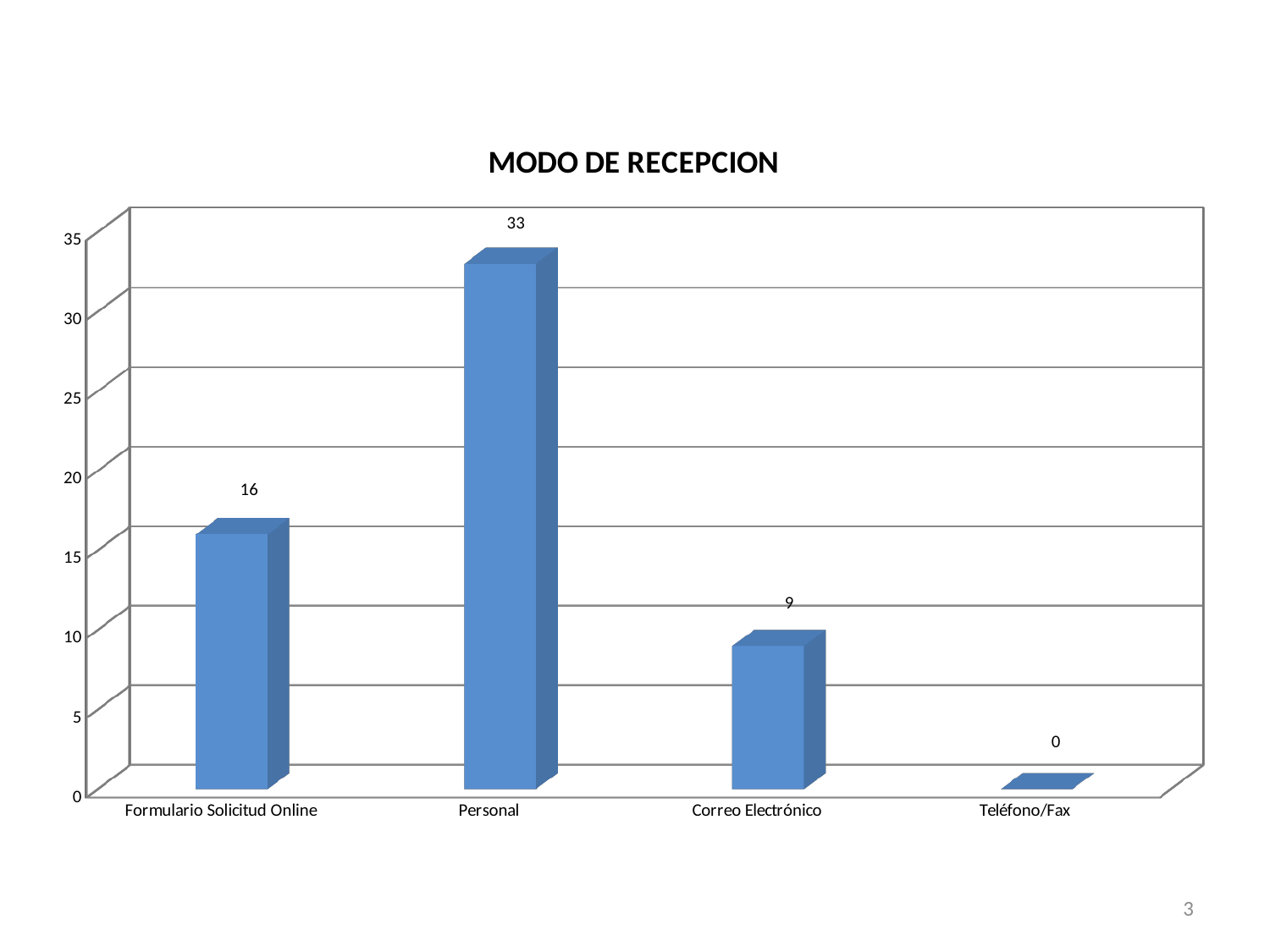
What is the difference between the values for Formulario Solicitud Online and Correo Electrónico? 7 What is the value for Correo Electrónico? 9 Is the value for Personal greater or less than 30? greater What is the value for Teléfono/Fax? 0 Which category has the lowest value? Teléfono/Fax Which is larger, the value for Correo Electrónico or the value for Formulario Solicitud Online? Formulario Solicitud Online What is the value for Formulario Solicitud Online? 16 What is the title of the chart? MODO DE RECEPCION What is the value for Personal? 33 How many categories are shown on the x axis? 4 Which category has the highest value? Personal What is the difference between the values for Personal and Formulario Solicitud Online? 17